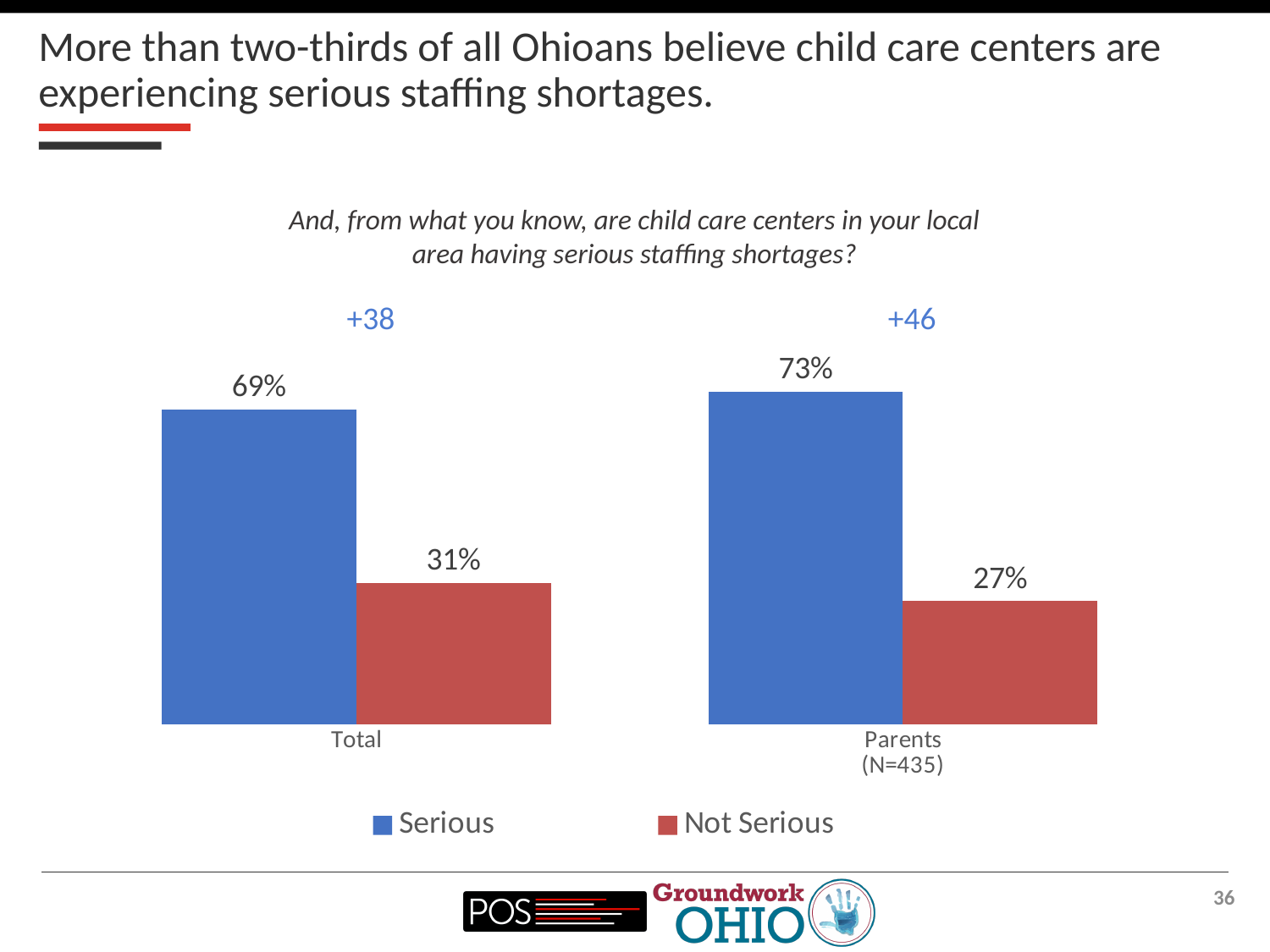
What is the 'Serious' value for Parents (N=435)? 73% What kind of chart is shown on the slide? Bar chart How many categories are shown on the x axis? 2 What percentage of the Total group said child care centers are having serious staffing shortages? 69% How many series does the legend list? 2 Which group has the higher 'Serious' percentage, Total or Parents (N=435)? Parents (N=435) What percentage of Parents (N=435) said staffing shortages are not serious? 27% What is the difference between the 'Serious' and 'Not Serious' percentages for the Total group? 38 What is the difference between the 'Serious' and 'Not Serious' percentages for Parents (N=435)? 46 What net figure is shown above the Parents (N=435) bars? +46 What colour represents the 'Not Serious' series? Red What is the 'Not Serious' value for the Total group? 31%